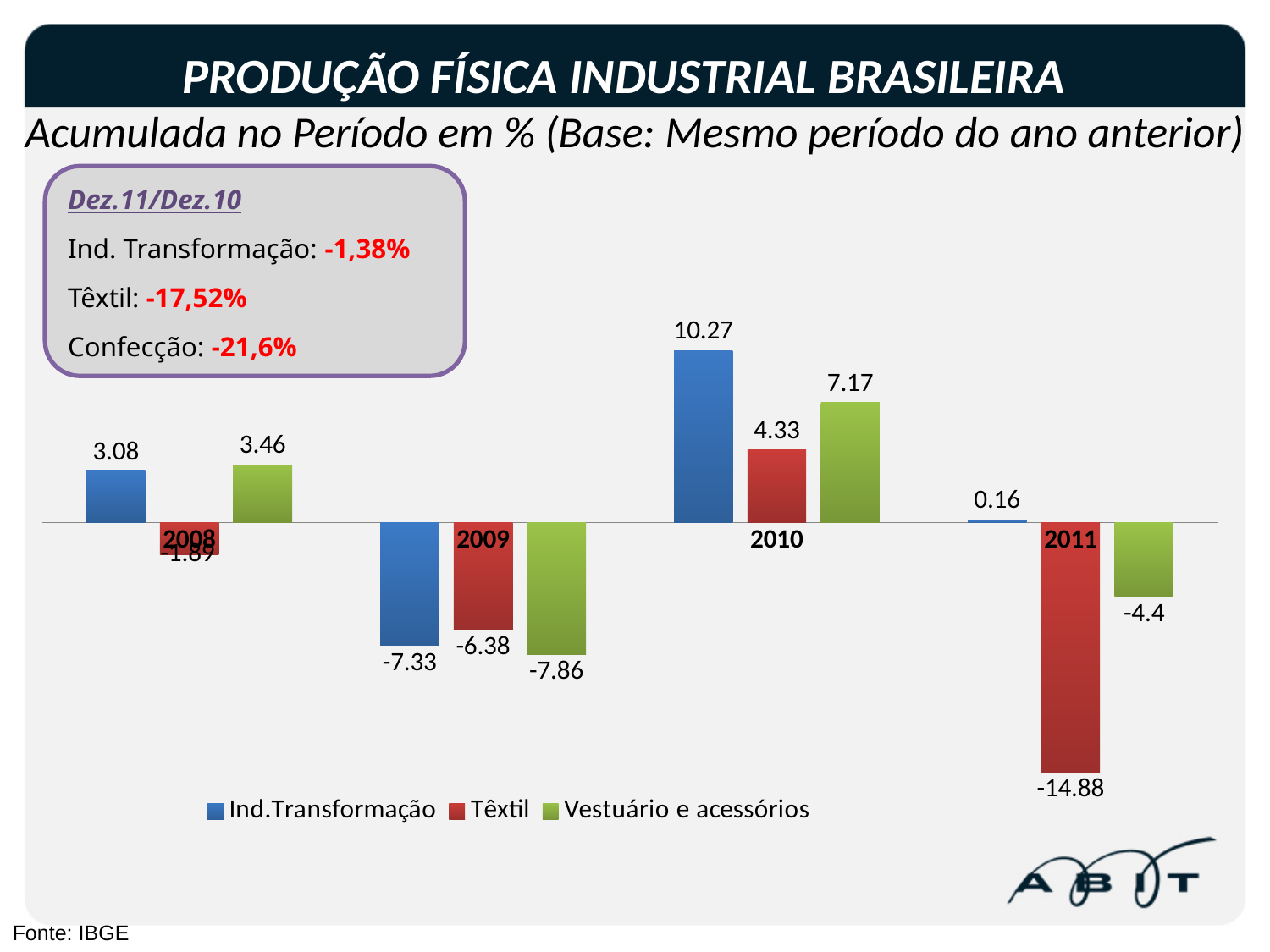
What is the value for Vestuário e acessórios in 2009? -7.86 How many series does the legend list? 3 How many years are shown on the x axis? 4 What is the value for Têxtil in 2011? -14.88 In which year is the Têxtil value lowest? 2011 What is the difference between the Ind.Transformação and Vestuário e acessórios values in 2010? 3.1 What is the value for Ind.Transformação in 2010? 10.27 In 2009, which is larger: the Ind.Transformação value or the Vestuário e acessórios value? Ind.Transformação What kind of chart is shown on the slide? Bar chart Does the Têxtil value rise or fall from 2010 to 2011? Fall What is the value for Vestuário e acessórios in 2011? -4.4 In which year is the Ind.Transformação value highest? 2010